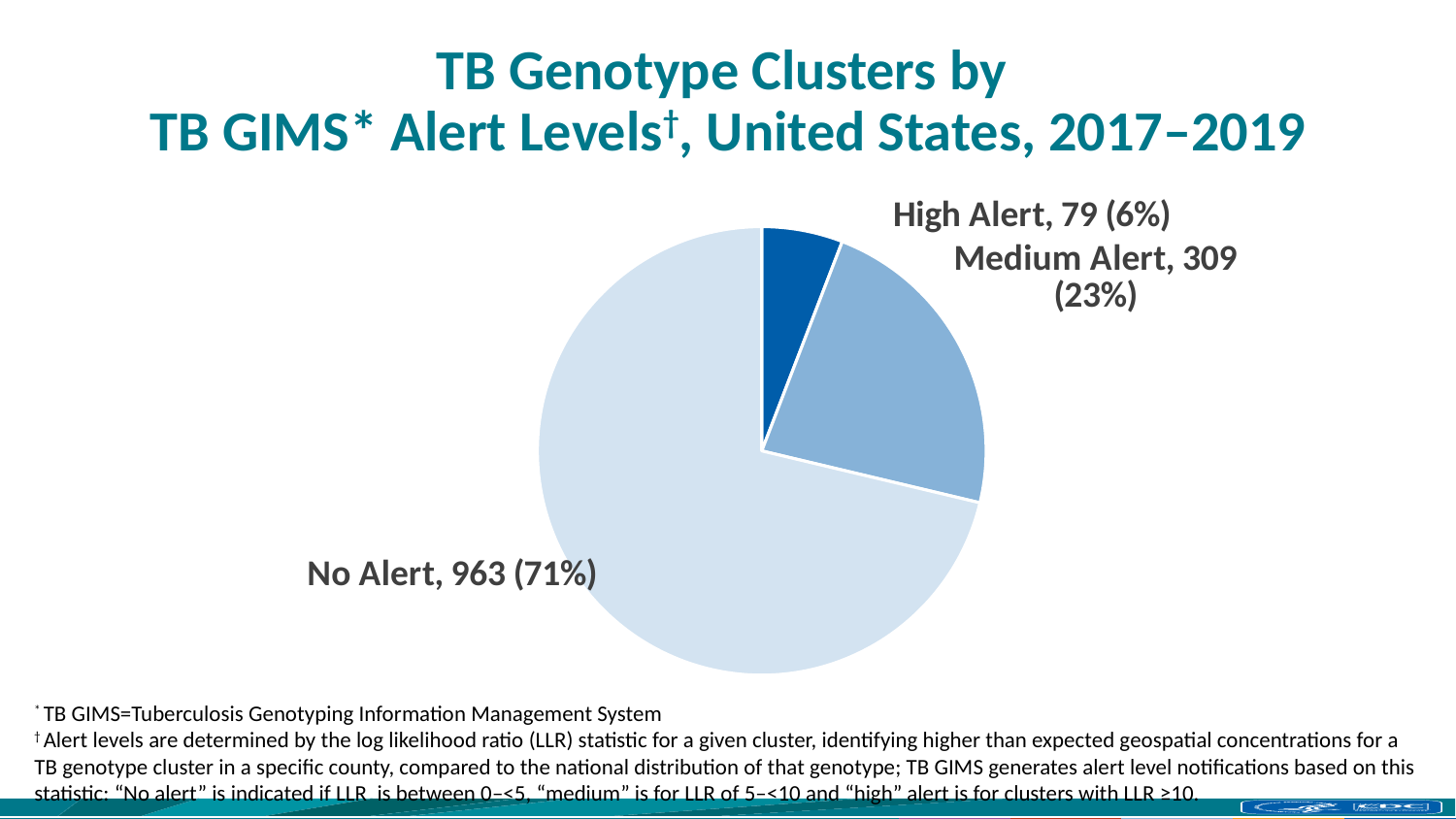
How many TB genotype clusters are in the High Alert category? 79 Which alert level has the smallest number of clusters? High Alert Which category has more clusters, Medium Alert or High Alert? Medium Alert How many more clusters are in the Medium Alert category than in the High Alert category? 230 How many TB genotype clusters are in the Medium Alert category? 309 What percentage of clusters are in the Medium Alert category? 23% Which alert level has the largest number of clusters? No Alert How many alert level categories are shown in the pie chart? 3 How many TB genotype clusters are in the No Alert category? 963 What is the total number of clusters across all three alert levels? 1,351 What share of the pie does the No Alert slice represent? 71% What kind of chart is shown on the slide? pie chart